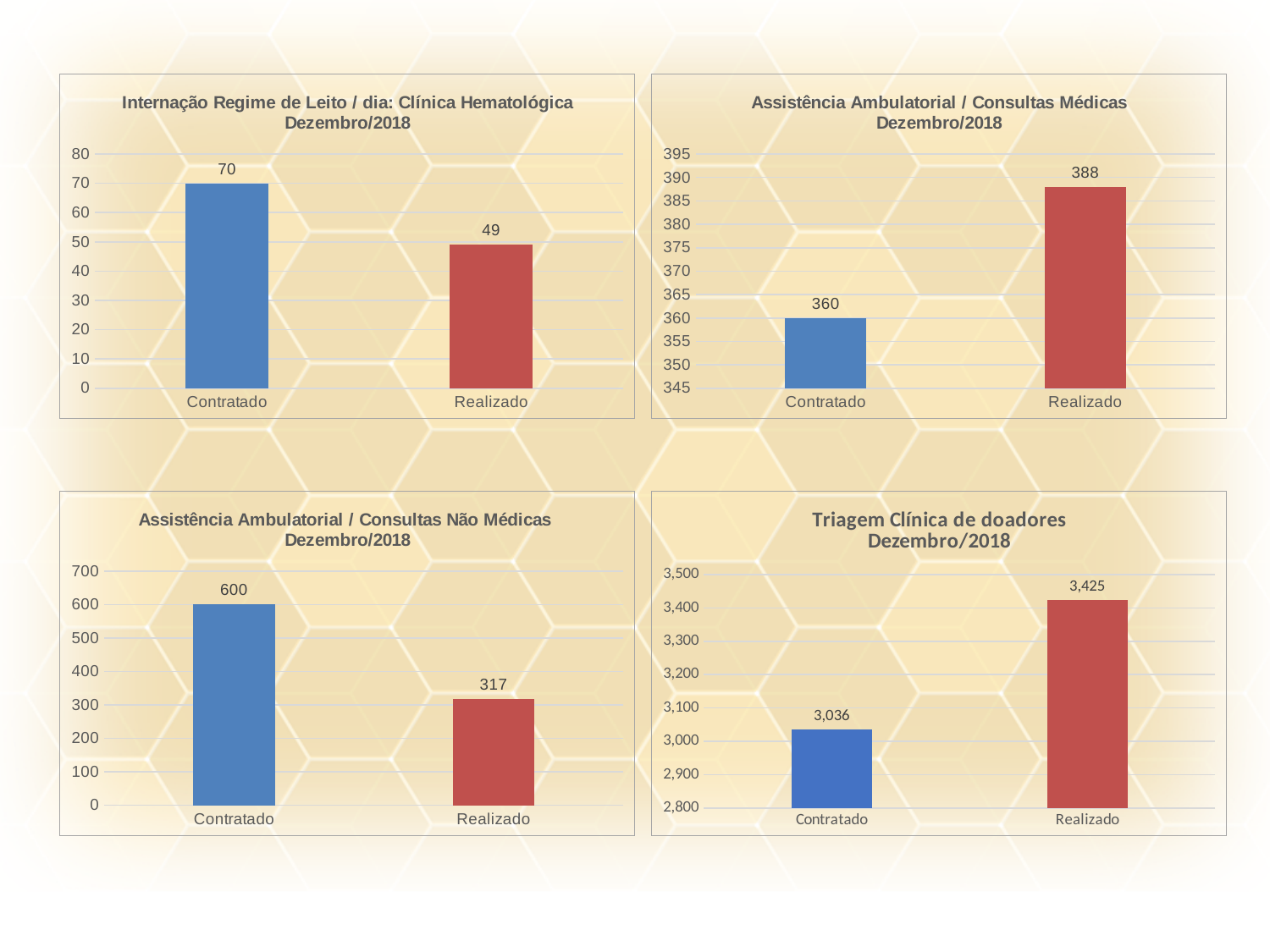
In the 'Assistência Ambulatorial / Consultas Médicas' chart, what is the difference between Realizado and Contratado? 28 In the 'Assistência Ambulatorial / Consultas Não Médicas' chart, what is the value for Contratado? 600 In the 'Internação Regime de Leito / dia: Clínica Hematológica' chart, what is the difference between Contratado and Realizado? 21 In the 'Internação Regime de Leito / dia: Clínica Hematológica' chart, what is the value for Realizado? 49 What kind of chart is the 'Triagem Clínica de doadores' chart? bar chart In the 'Internação Regime de Leito / dia: Clínica Hematológica' chart, what is the value for Contratado? 70 In the 'Triagem Clínica de doadores' chart, is the value for Contratado greater or less than 3,100? less In the 'Assistência Ambulatorial / Consultas Não Médicas' chart, what is the difference between Contratado and Realizado? 283 In the 'Triagem Clínica de doadores' chart, what is the value for Realizado? 3,425 In the 'Assistência Ambulatorial / Consultas Médicas' chart, what is the value for Realizado? 388 In the 'Assistência Ambulatorial / Consultas Médicas' chart, which category has the higher value? Realizado In the 'Assistência Ambulatorial / Consultas Não Médicas' chart, which category has the lower value? Realizado